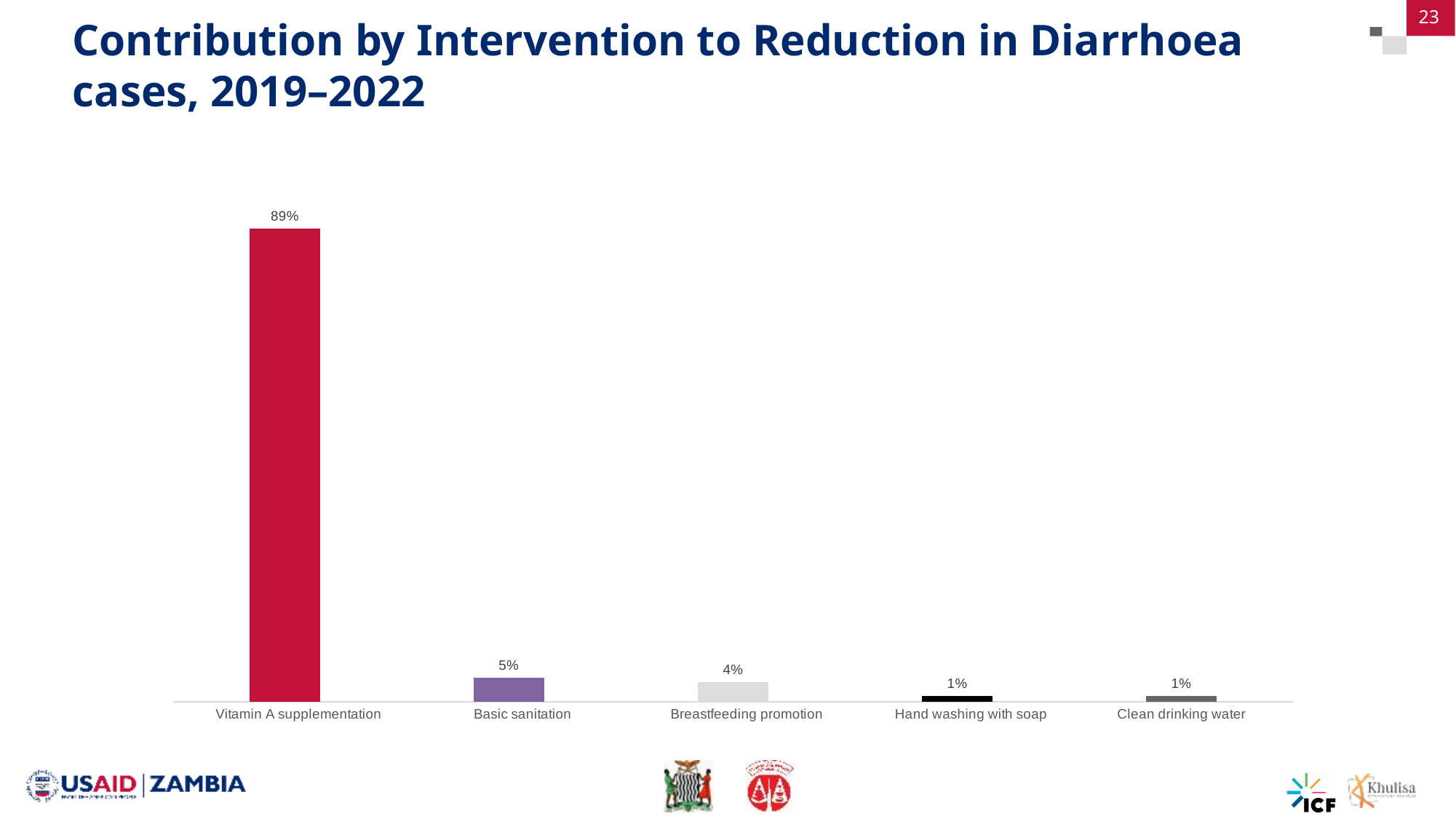
What is the value for Breastfeeding promotion? 4% Which intervention has the highest contribution? Vitamin A supplementation What is the value for Hand washing with soap? 1% What is the difference between the values for Vitamin A supplementation and Basic sanitation? 84% What kind of chart is shown on the slide? Bar chart What is the value for Vitamin A supplementation? 89% What colour is the bar for Vitamin A supplementation? Red Do the values rise or fall from left to right across the categories? Fall Which is larger, the value for Basic sanitation or the value for Clean drinking water? Basic sanitation What is the value for Basic sanitation? 5% What is the difference between the values for Basic sanitation and Breastfeeding promotion? 1% How many interventions are shown on the chart? 5